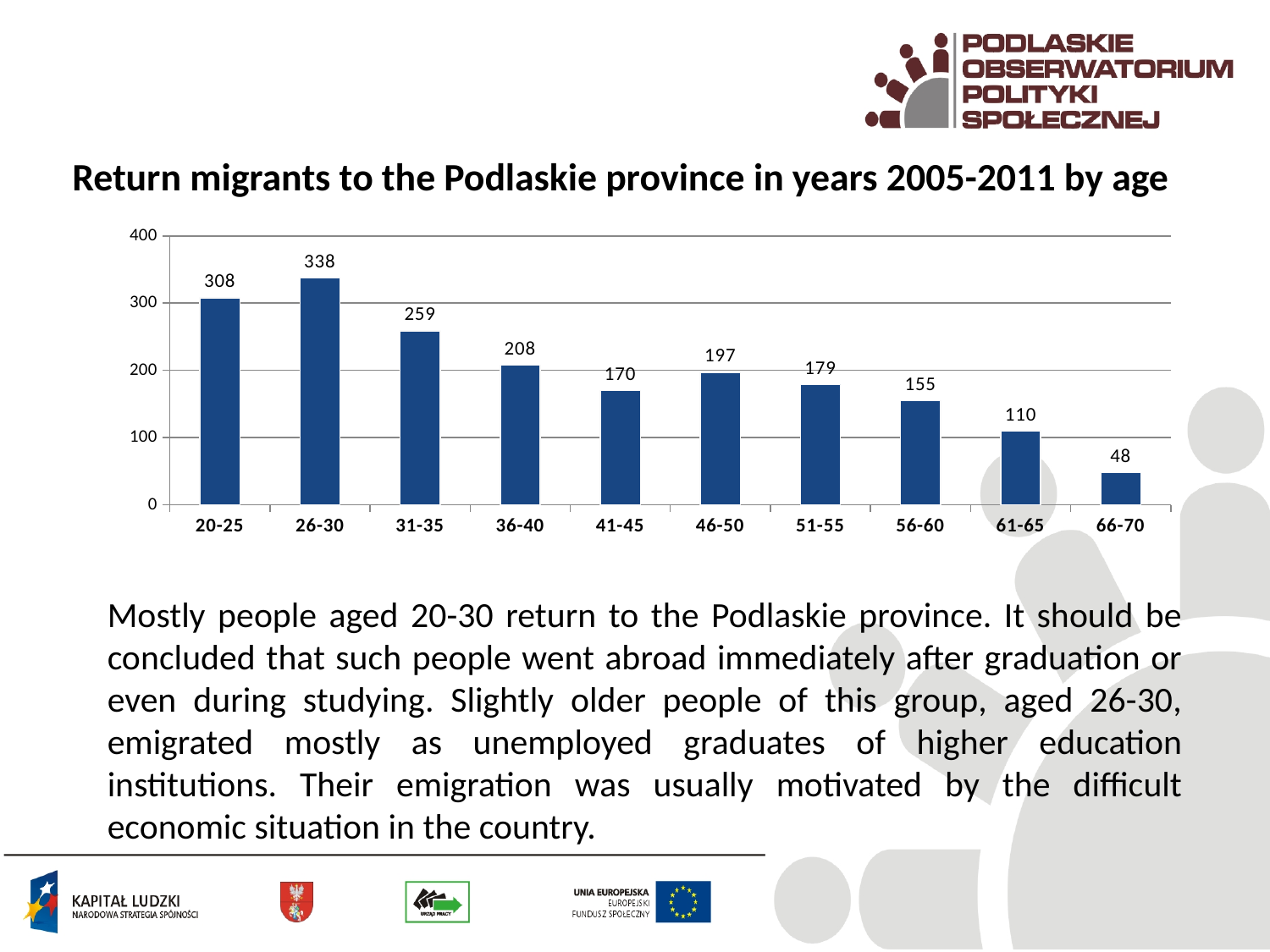
Which age group has a larger value, 46-50 or 51-55? 46-50 Which age group has the lowest number of return migrants? 66-70 What is the value shown for the 41-45 age group? 170 What kind of chart is shown on the slide? bar chart What is the value shown for the 66-70 age group? 48 How many age groups are shown on the chart? 10 What is the difference between the values for the 20-25 and 31-35 age groups? 49 What is the number of return migrants aged 26-30? 338 Do the values generally rise or fall from the 26-30 age group to the 66-70 age group? fall Is the value for the 56-60 age group greater or less than 200? less Which age group has the highest number of return migrants? 26-30 What is the title of the chart? Return migrants to the Podlaskie province in years 2005-2011 by age